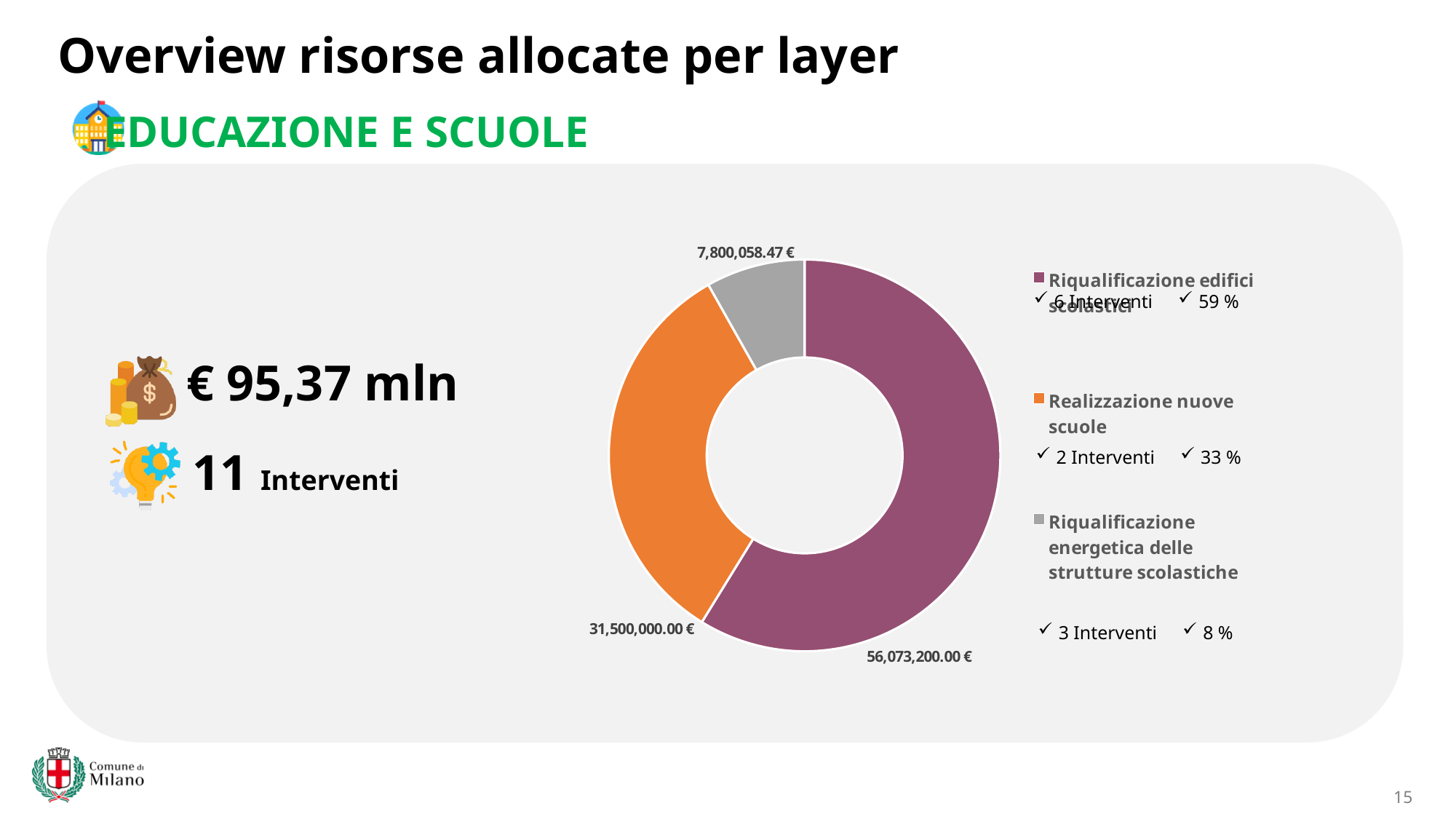
What is the value for Realizzazione nuove scuole? 31,500,000.00 € What is the difference between the values for Riqualificazione edifici scolastici and Realizzazione nuove scuole? 24,573,200.00 € What is the value for Riqualificazione edifici scolastici? 56,073,200.00 € What share of the chart does Riqualificazione edifici scolastici represent, as shown on the slide? 59 % Which category has the largest slice of the chart? Riqualificazione edifici scolastici What share of the chart does Realizzazione nuove scuole represent, as shown on the slide? 33 % Which is larger: the value for Realizzazione nuove scuole or the value for Riqualificazione energetica delle strutture scolastiche? Realizzazione nuove scuole What is the value for Riqualificazione energetica delle strutture scolastiche? 7,800,058.47 € What colour is the slice for Realizzazione nuove scuole? Orange How many categories does the chart show? 3 What type of chart is shown on the slide? Donut (pie) chart Which category has the smallest slice of the chart? Riqualificazione energetica delle strutture scolastiche